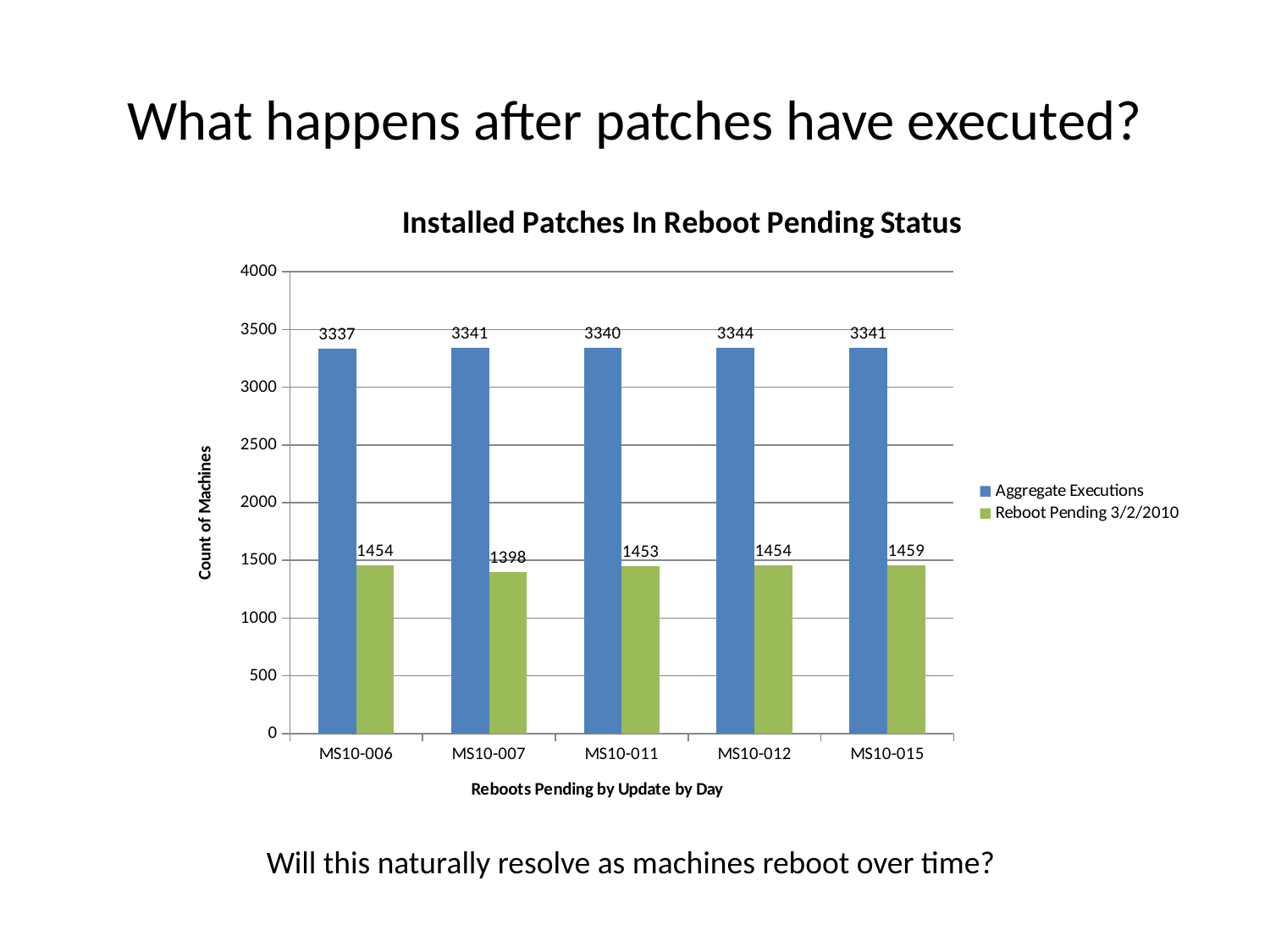
How many series does the legend list? 2 What kind of chart is shown on the slide? Bar chart What is the Aggregate Executions value for MS10-006? 3337 What is the title of the chart? Installed Patches In Reboot Pending Status What is the difference between Aggregate Executions and Reboot Pending 3/2/2010 for MS10-011? 1887 Which category has the highest Reboot Pending 3/2/2010 value? MS10-015 Which is larger for MS10-006: Aggregate Executions or Reboot Pending 3/2/2010? Aggregate Executions What is the Aggregate Executions value for MS10-012? 3344 Which category has the lowest Reboot Pending 3/2/2010 value? MS10-007 How many categories are shown on the x axis? 5 What is the Reboot Pending 3/2/2010 value for MS10-007? 1398 What is the Reboot Pending 3/2/2010 value for MS10-015? 1459